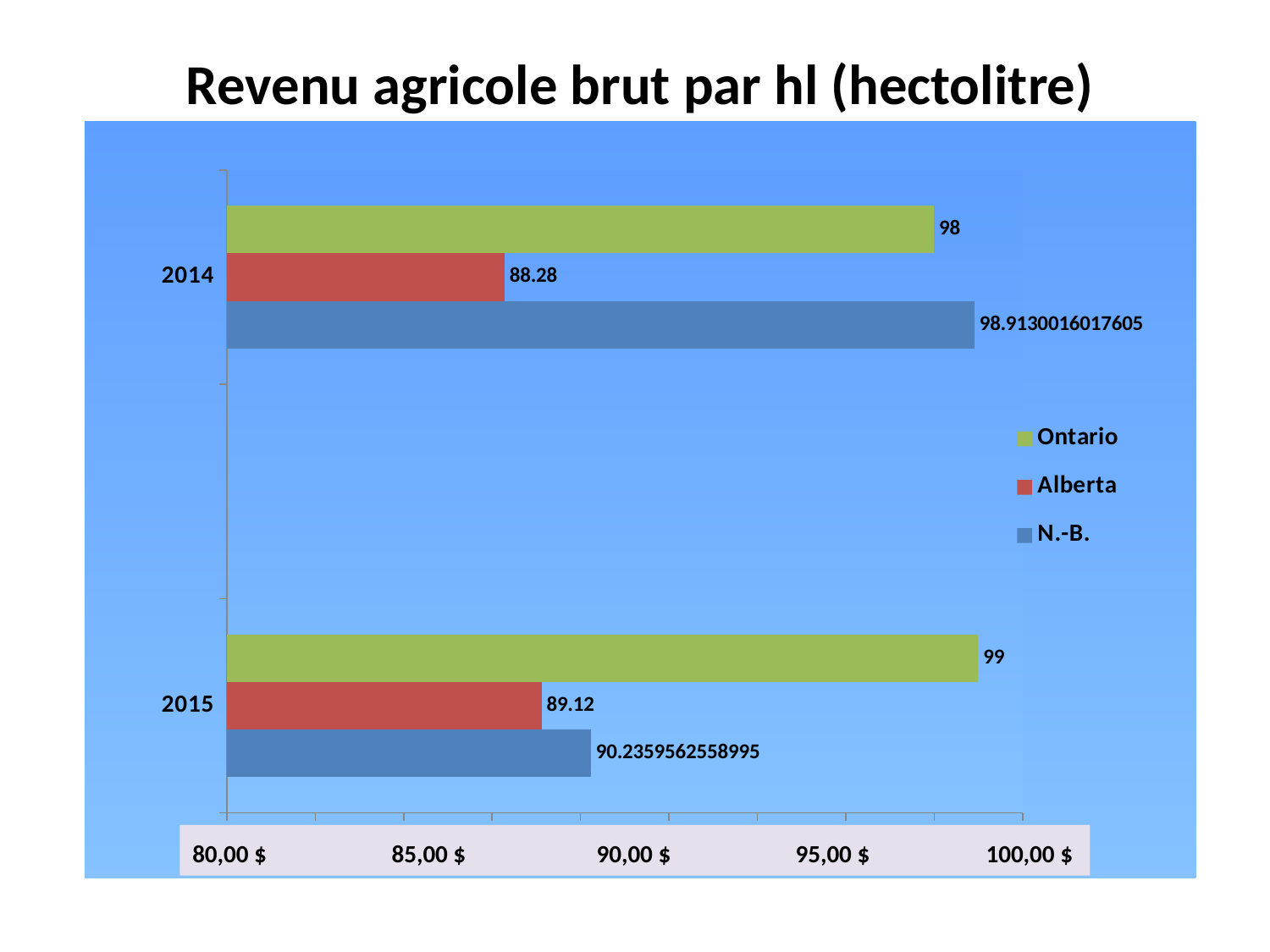
How many series does the legend list? 3 Which series has the lowest value in 2015? Alberta What is the value for Alberta in 2015? 89.12 Which is larger in 2015, the value for Ontario or the value for N.-B.? Ontario What kind of chart is shown on the slide? bar chart What is the value for N.-B. in 2015? 90.2359562558995 What is the title of the chart? Revenu agricole brut par hl (hectolitre) What is the value for Alberta in 2014? 88.28 What is the value for Ontario in 2014? 98 Which series has the highest value in 2014? N.-B. What is the difference between Ontario's 2015 value and its 2014 value? 1 Is the value for Alberta in 2014 greater or less than 90,00 $? less